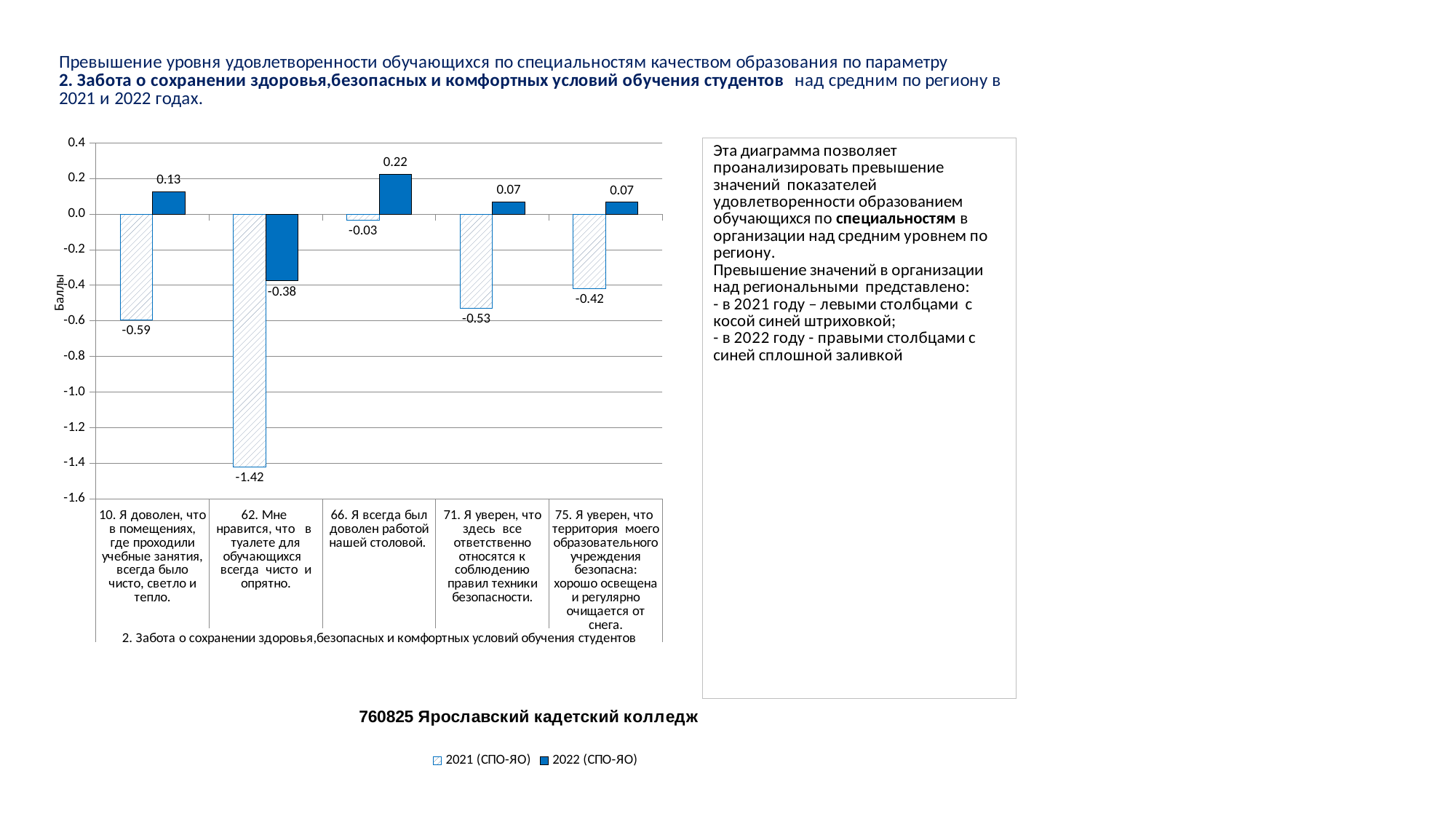
For statement 71, which is larger: the 2021 value or the 2022 value? 2022 What is the 2021 (СПО-ЯО) value for statement 62 (about the toilet being clean and tidy)? -1.42 How many statements (categories) are shown on the x axis? 5 How many series does the legend list? 2 What type of chart is shown on the slide? Bar chart What is the 2021 (СПО-ЯО) value for statement 10 (rooms clean, light and warm)? -0.59 What is the 2022 (СПО-ЯО) value for statement 66 (satisfied with the canteen)? 0.22 What is the 2022 (СПО-ЯО) value for statement 75 (territory is safe, well lit and cleared of snow)? 0.07 Which statement has the lowest 2021 (СПО-ЯО) value? 62. Мне нравится, что в туалете для обучающихся всегда чисто и опрятно. What is the label of the y axis? Баллы Which statement has the highest 2022 (СПО-ЯО) value? 66. Я всегда был доволен работой нашей столовой. What is the difference between the 2022 and 2021 values for statement 62? 1.04